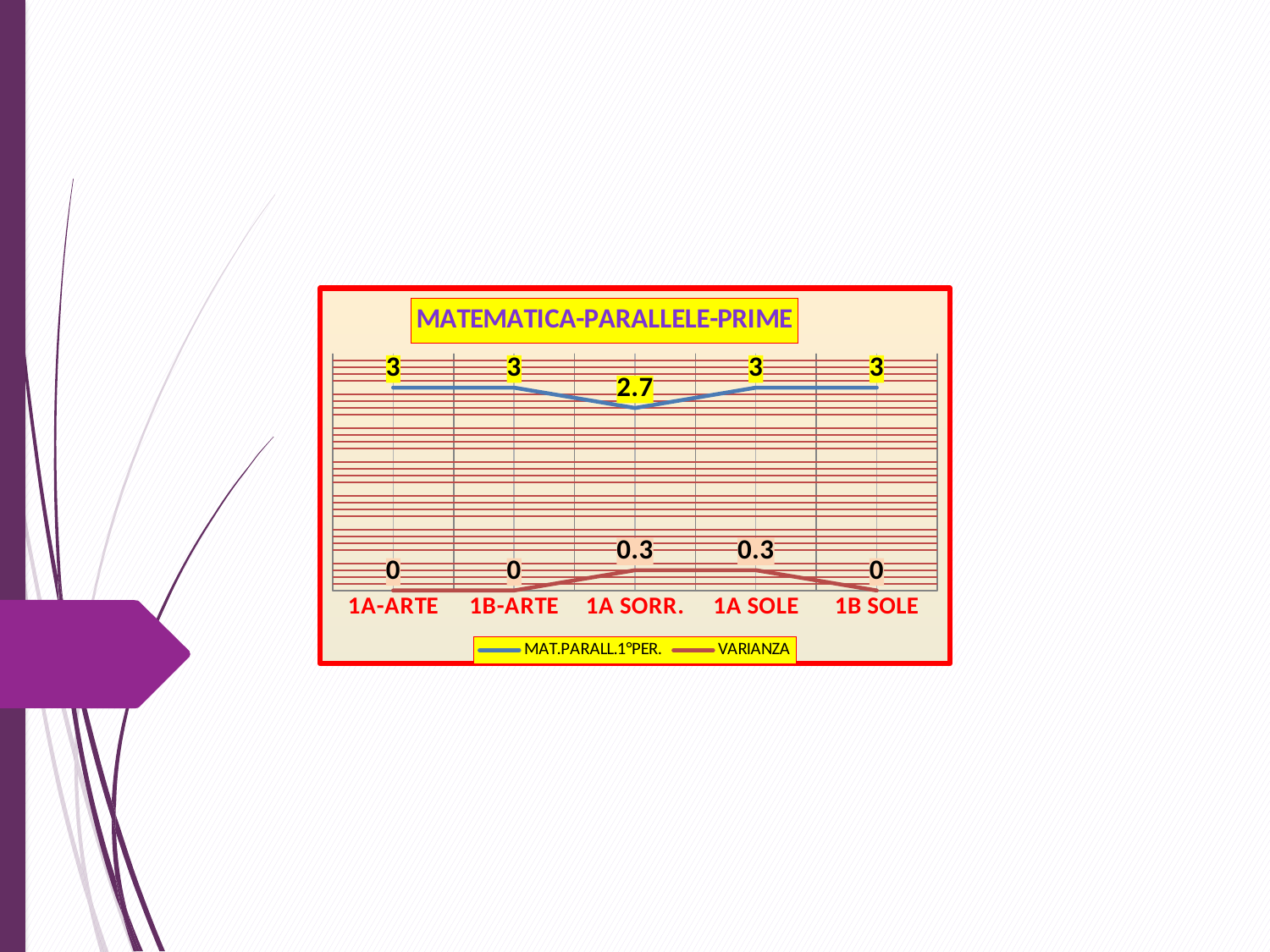
What is the VARIANZA value for 1A SOLE? 0.3 What is the MAT.PARALL.1°PER. value for 1A SORR.? 2.7 What is the difference between the MAT.PARALL.1°PER. values for 1A-ARTE and 1A SORR.? 0.3 Which is larger, the VARIANZA value for 1A SORR. or for 1A-ARTE? 1A SORR. What is the title of the chart? MATEMATICA-PARALLELE-PRIME What type of chart is shown on the slide? line chart How many categories are shown on the x axis? 5 How many series does the legend list? 2 What is the MAT.PARALL.1°PER. value for 1B-ARTE? 3 Which series is drawn in blue? MAT.PARALL.1°PER. What is the VARIANZA value for 1B SOLE? 0 Which category has the lowest MAT.PARALL.1°PER. value? 1A SORR.